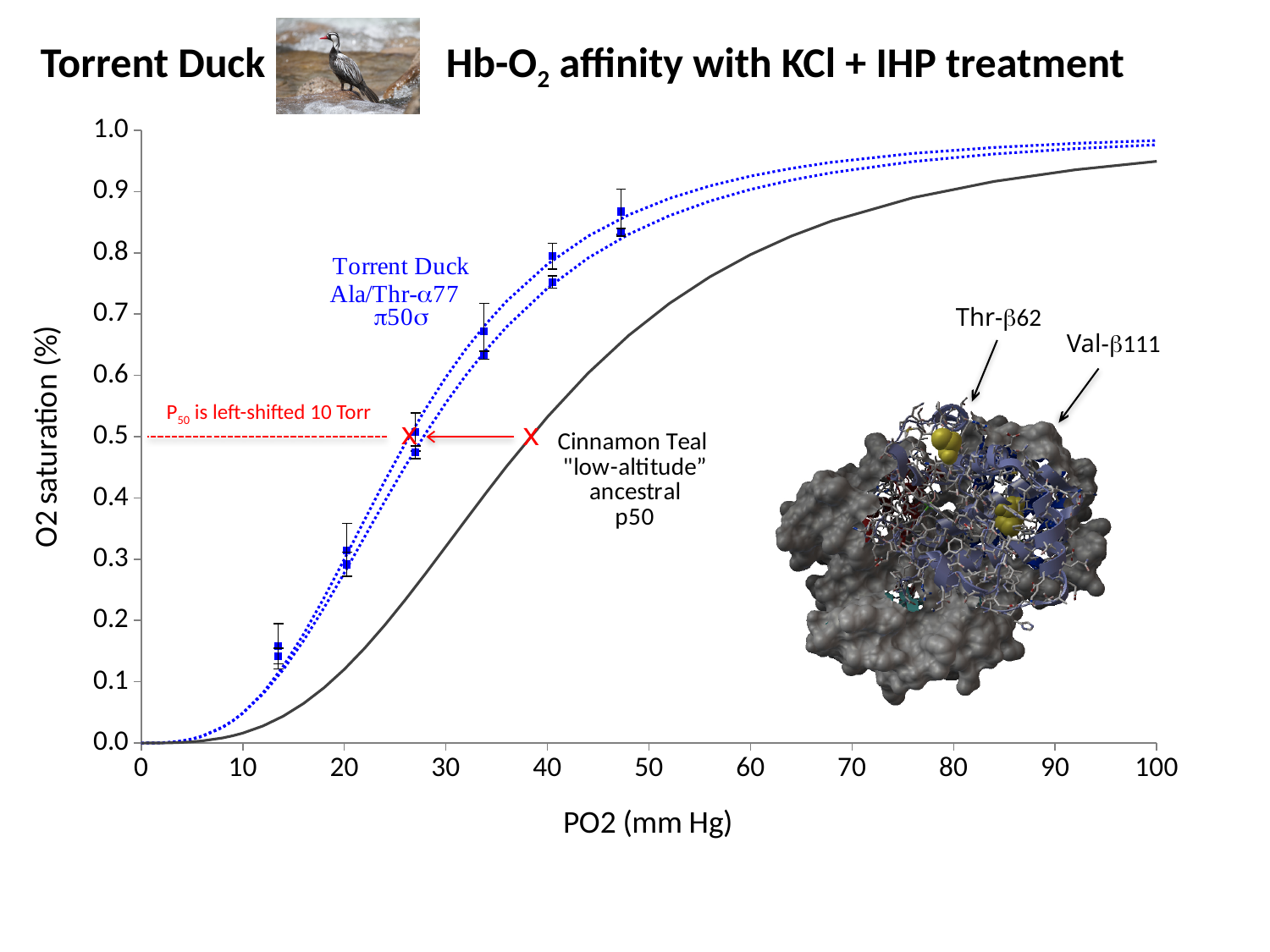
Is the Cinnamon Teal O2 saturation at a PO2 of 20 mm Hg greater or less than 0.2? less Is the Torrent Duck O2 saturation at a PO2 of 40 mm Hg greater or less than 0.7? greater How many curves are plotted on the chart? 3 Is the Torrent Duck O2 saturation at a PO2 of 60 mm Hg greater or less than 0.8? greater What is the label of the y axis? O2 saturation (%) What kind of chart is shown on the slide? line chart According to the annotation, by how much is the Torrent Duck P50 left-shifted relative to the Cinnamon Teal ancestral p50? 10 Torr What is the label of the x axis? PO2 (mm Hg) What is the maximum value shown on the x axis? 100 Does O2 saturation rise or fall as PO2 increases along the x axis? rise At a PO2 of 40 mm Hg, which curve shows higher O2 saturation, Torrent Duck or Cinnamon Teal? Torrent Duck